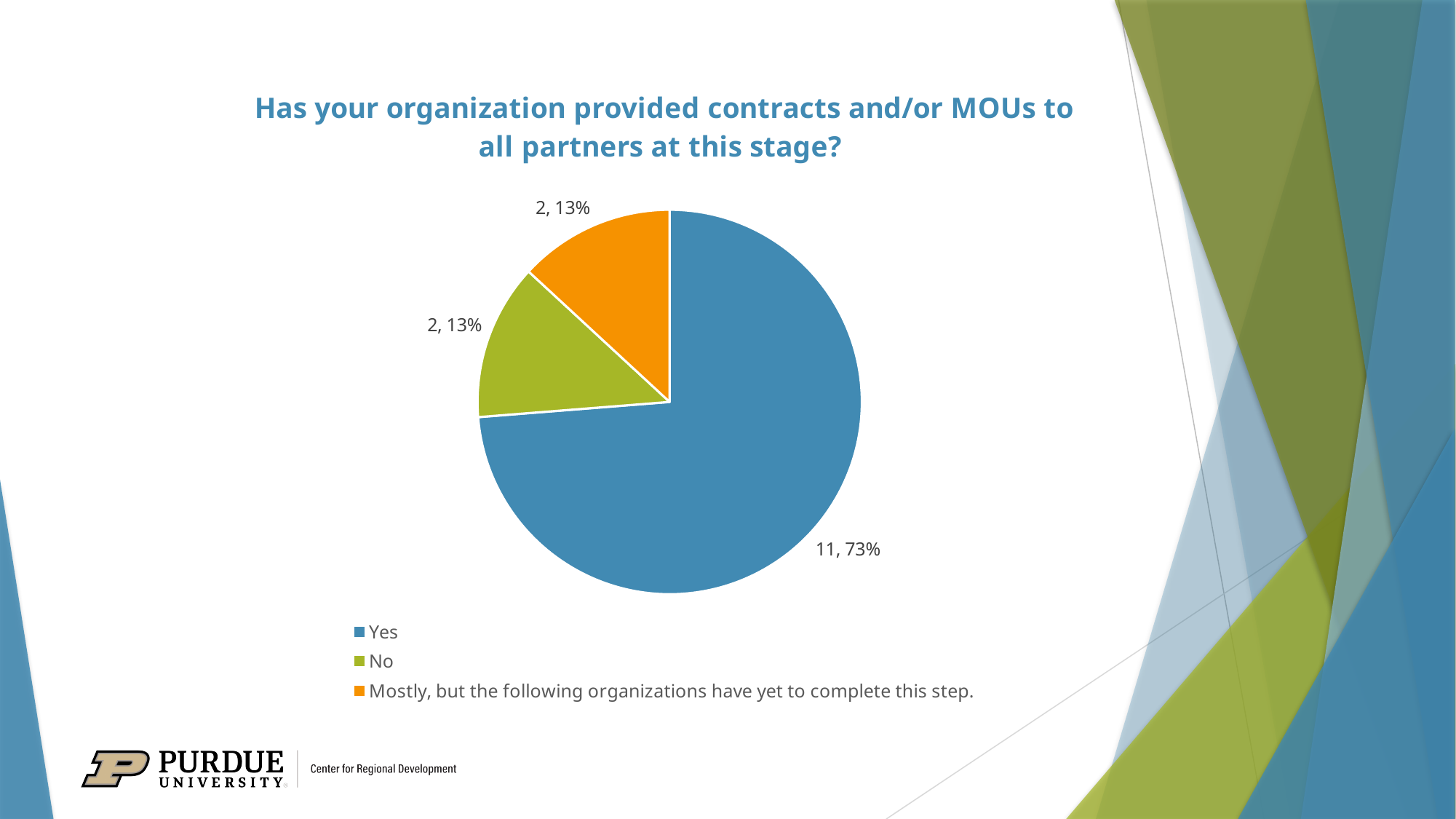
How many respondents answered "No"? 2 How many entries does the legend list? 3 Which response category has the largest slice of the pie? Yes What percentage is shown for the "Mostly, but the following organizations have yet to complete this step." slice? 13% What is the total number of responses across all slices of the pie? 15 How many slices does the pie chart have? 3 What colour is the "Yes" slice in the pie chart? blue How many respondents answered "Yes"? 11 What percentage of the pie does the "No" slice represent? 13% What is the difference in count between the "Yes" and "No" responses? 9 What percentage of the pie does the "Yes" slice represent? 73% What kind of chart is shown on the slide? pie chart